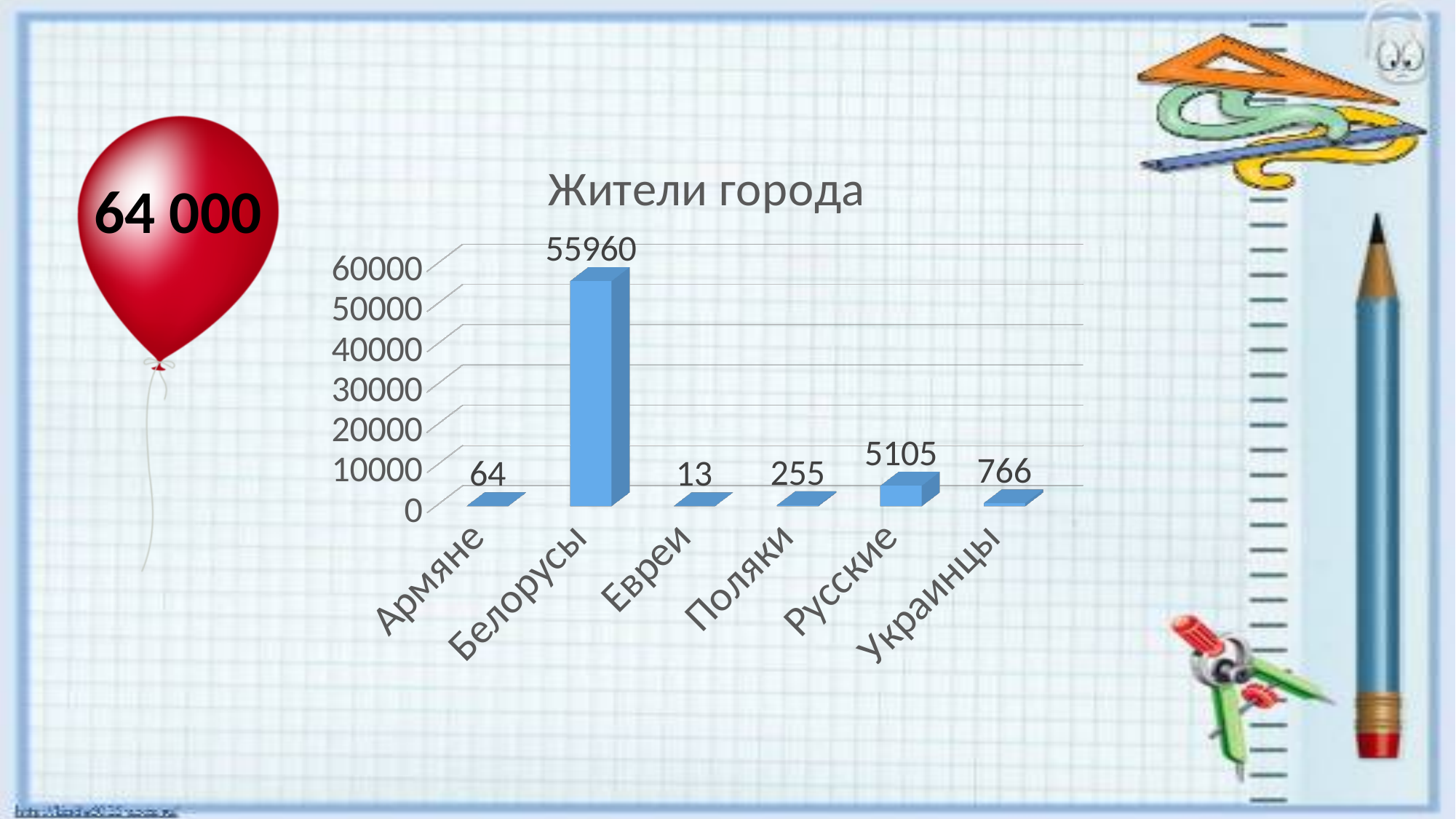
What is the value for Евреи? 13 Which is larger, the value for Поляки or the value for Армяне? Поляки What is the difference between the values for Русские and Украинцы? 4339 Is the value for Белорусы greater or less than 50000? greater Which category has the highest value? Белорусы What is the value for Белорусы? 55960 How many categories are shown on the x axis? 6 What is the value for Русские? 5105 Which category has the lowest value? Евреи What is the value for Украинцы? 766 What kind of chart is shown? bar chart What is the title of the chart? Жители города